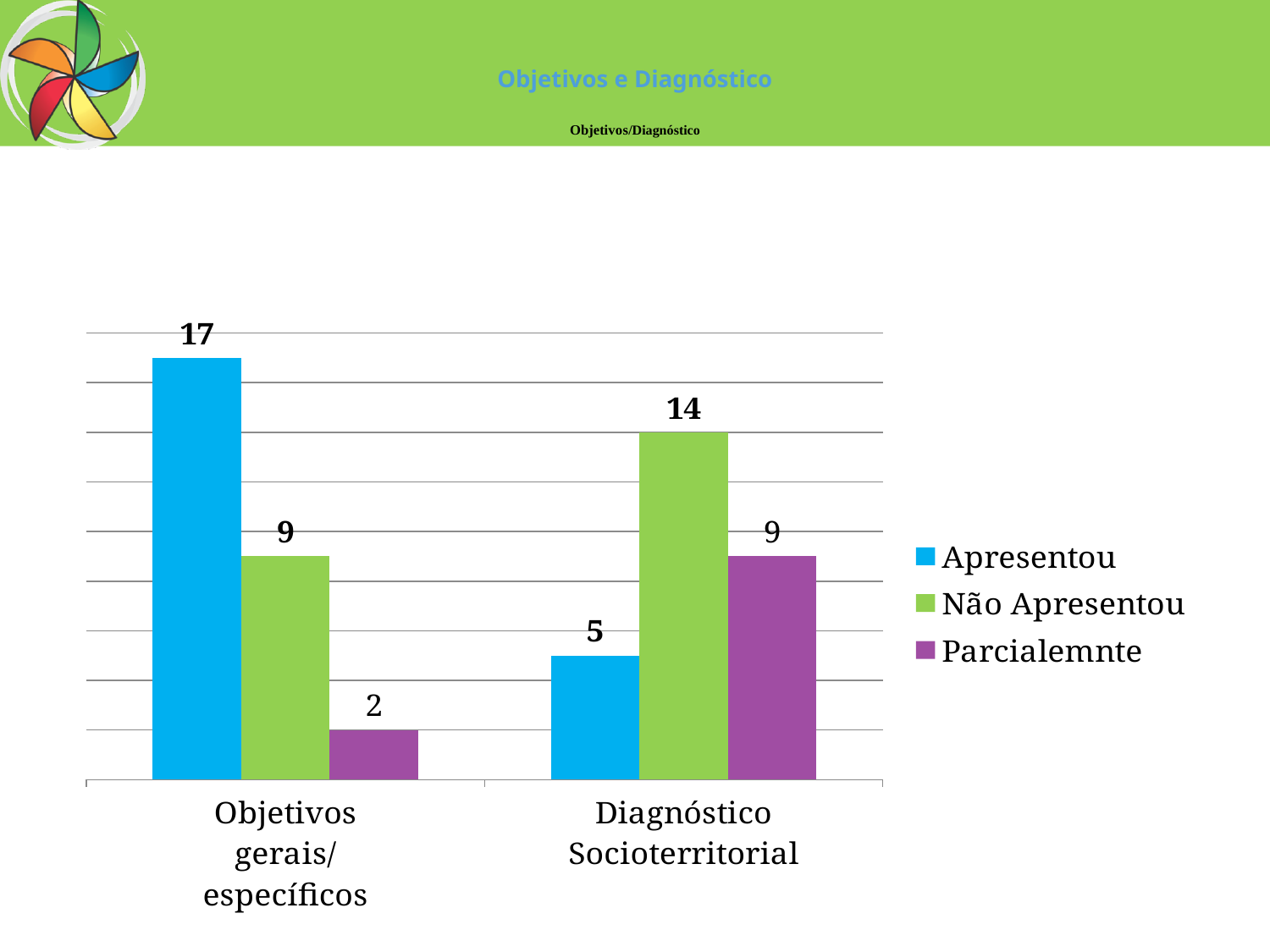
Which is larger: Não Apresentou for Objetivos gerais/específicos or Não Apresentou for Diagnóstico Socioterritorial? Diagnóstico Socioterritorial How many series does the legend list? 3 Which series has the highest value in the Objetivos gerais/específicos category? Apresentou What kind of chart is shown on the slide? Bar chart What is the value for Apresentou in the Diagnóstico Socioterritorial category? 5 What is the value for Apresentou in the Objetivos gerais/específicos category? 17 How many categories are shown on the x axis? 2 What is the value for Parcialemnte in the Objetivos gerais/específicos category? 2 What colour are the Não Apresentou bars? Green Which series has the lowest value in the Diagnóstico Socioterritorial category? Apresentou What is the value for Não Apresentou in the Diagnóstico Socioterritorial category? 14 What is the difference between the Apresentou values for Objetivos gerais/específicos and Diagnóstico Socioterritorial? 12